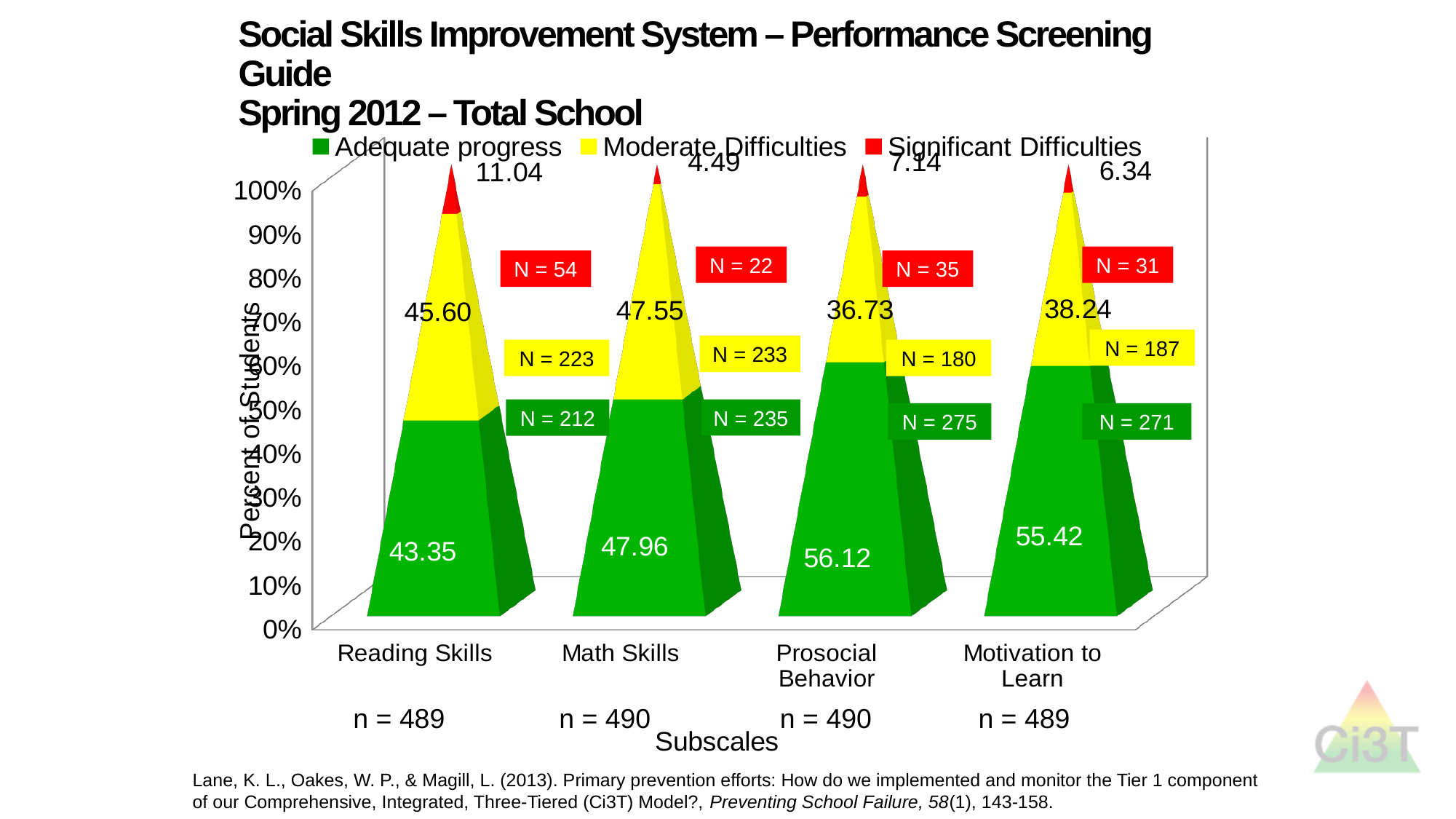
How many subscales are shown on the x axis? 4 What is the Adequate progress value for Motivation to Learn? 55.42 What is the Significant Difficulties value for Reading Skills? 11.04 Which subscale has the highest Adequate progress value? Prosocial Behavior How many series does the legend list? 3 What is the difference between the Adequate progress values for Prosocial Behavior and Reading Skills? 12.77 Which is larger, the Moderate Difficulties value for Reading Skills or for Motivation to Learn? Reading Skills What is the Moderate Difficulties value for Math Skills? 47.55 What is the Adequate progress value for Prosocial Behavior? 56.12 Which subscale has the lowest Significant Difficulties value? Math Skills What is the label of the y axis? Percent of Students What is the N value shown for Significant Difficulties in Math Skills? N = 22